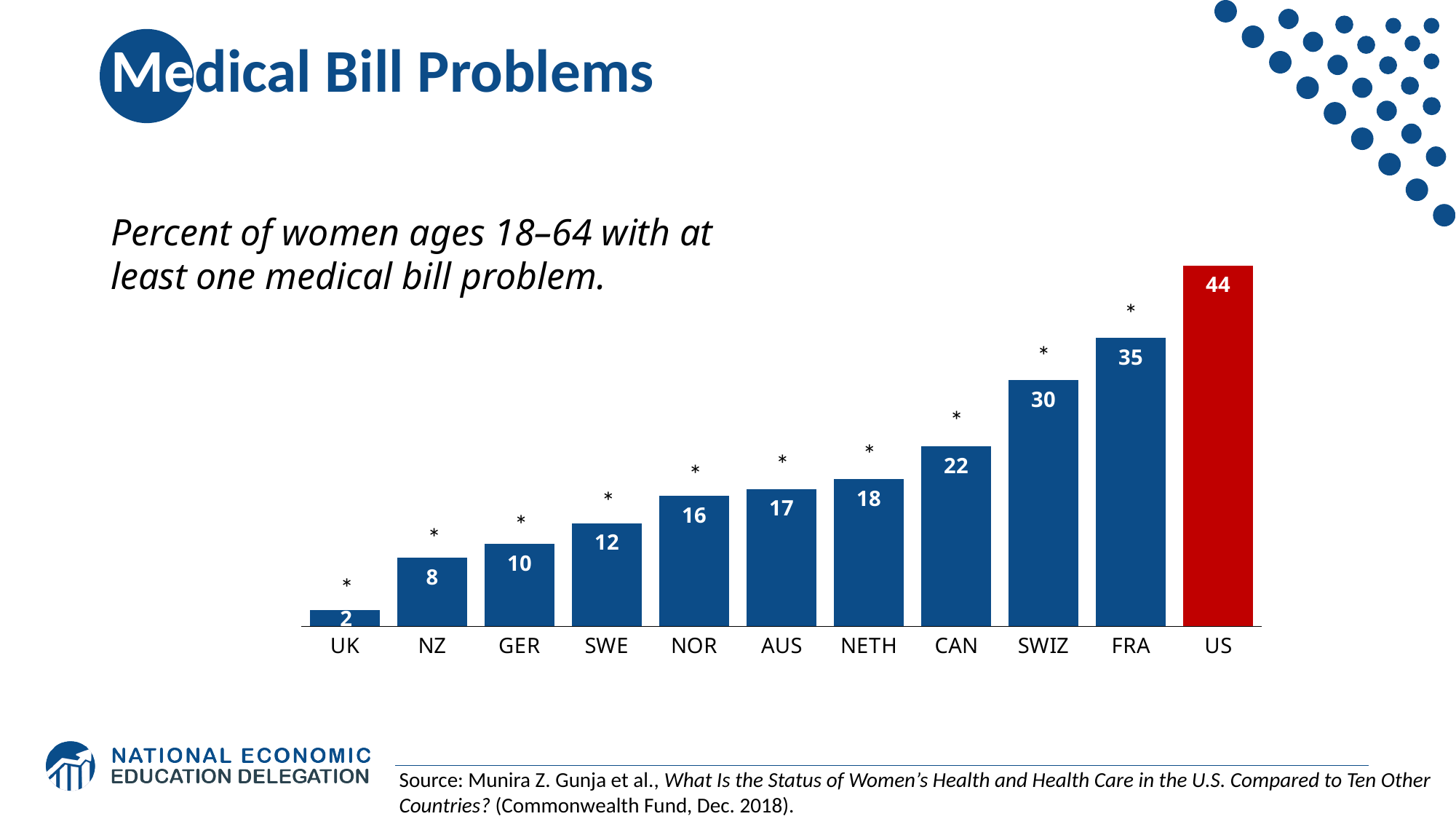
Which has a larger value, NOR or NETH? NETH What kind of chart is this? Bar chart What is the value for CAN? 22 What is the value for SWE? 12 How many countries are shown on the chart? 11 What is the difference between the values for SWIZ and NZ? 22 What is the difference between the values for the US and FRA? 9 Which country has the lowest value? UK What is the value for the US? 44 Which country has the highest value? US Do the values rise or fall from left to right along the x axis? Rise Which bar is coloured red rather than blue? US